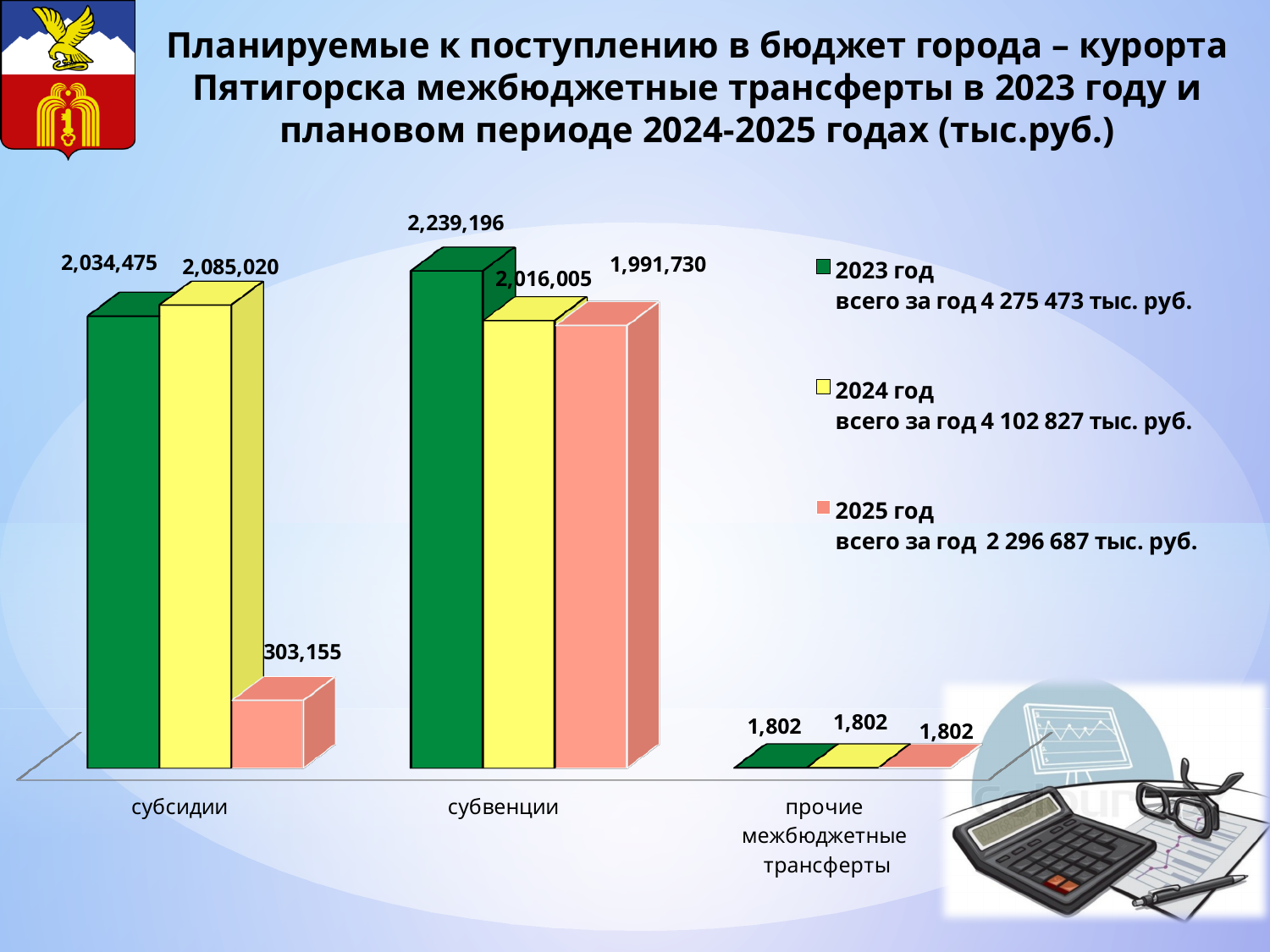
Which category has the highest value in the 2023 год series? субвенции What is the value for субсидии in the 2023 год series? 2,034,475 What is the value for субсидии in the 2025 год series? 303,155 What is the difference between the 2024 год and 2023 год values for субсидии? 50,545 How many categories are shown on the x axis? 3 What is the value for субвенции in the 2025 год series? 1,991,730 What kind of chart is shown on the slide? bar chart How many series does the legend list? 3 Which category has the lowest value in the 2025 год series? прочие межбюджетные трансферты What is the value for прочие межбюджетные трансферты in the 2024 год series? 1,802 According to the legend, what is the total for the year 2024 год? 4 102 827 тыс. руб. Which is larger for субвенции: the 2023 год value or the 2024 год value? 2023 год